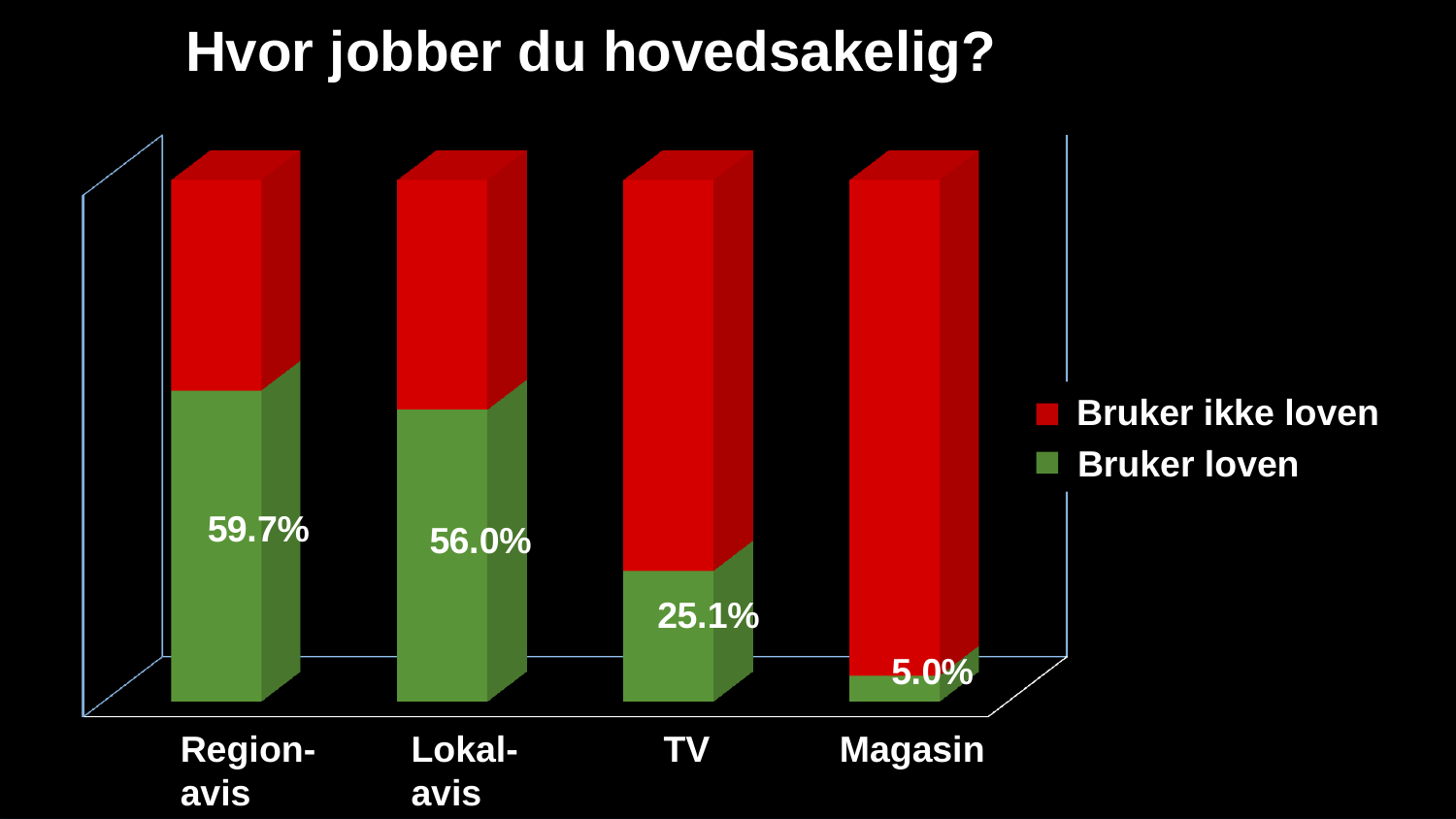
What kind of chart is shown on the slide? Stacked bar chart What is the value for Bruker loven for Magasin? 5.0% What is the difference between the Bruker loven values for TV and Magasin? 20.1% What is the value for Bruker loven for Regionavis? 59.7% Which is larger for Bruker loven: Lokalavis or TV? Lokalavis What is the difference between the Bruker loven values for Regionavis and Lokalavis? 3.7% How many series does the legend list? 2 How many categories are shown on the x axis? 4 What is the value for Bruker loven for Lokalavis? 56.0% What is the value for Bruker loven for TV? 25.1% Which category has the lowest value for Bruker loven? Magasin Which category has the highest value for Bruker loven? Regionavis